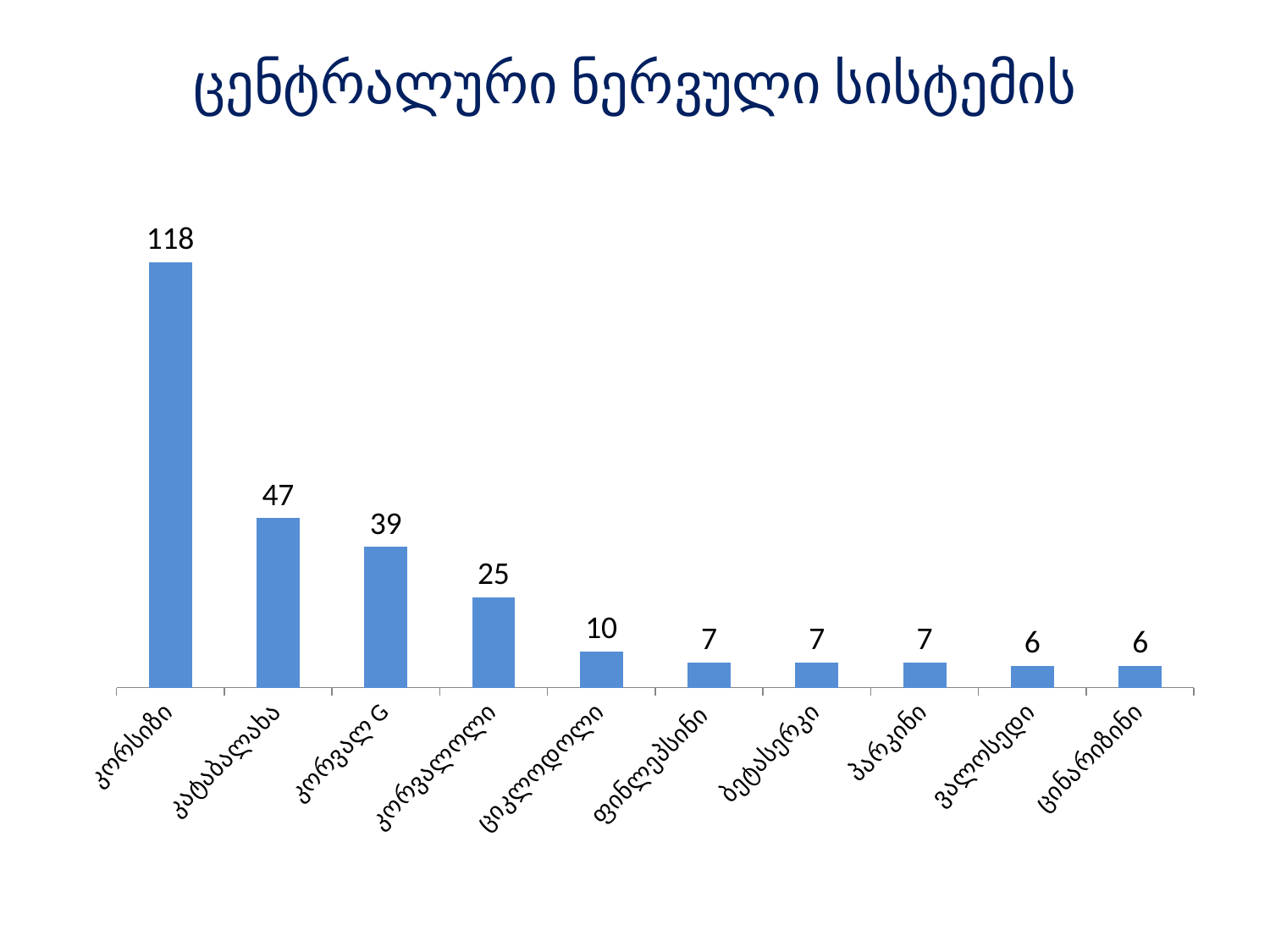
What kind of chart is shown on the slide? bar chart What is the difference between the values for კორვალ G and კორვალოლი? 14 What is the title of the chart? ცენტრალური ნერვული სისტემის Which category has the highest value? კორსიზი What is the value for კატაბალახა? 47 What is the value for კორვალოლი? 25 What is the value for კორსიზი? 118 Which is larger, the value for კატაბალახა or the value for კორვალ G? კატაბალახა Do the values rise or fall from left to right along the x axis? fall How many categories are shown in the chart? 10 What is the difference between the values for კორსიზი and კატაბალახა? 71 What is the value for ციკლოდოლი? 10